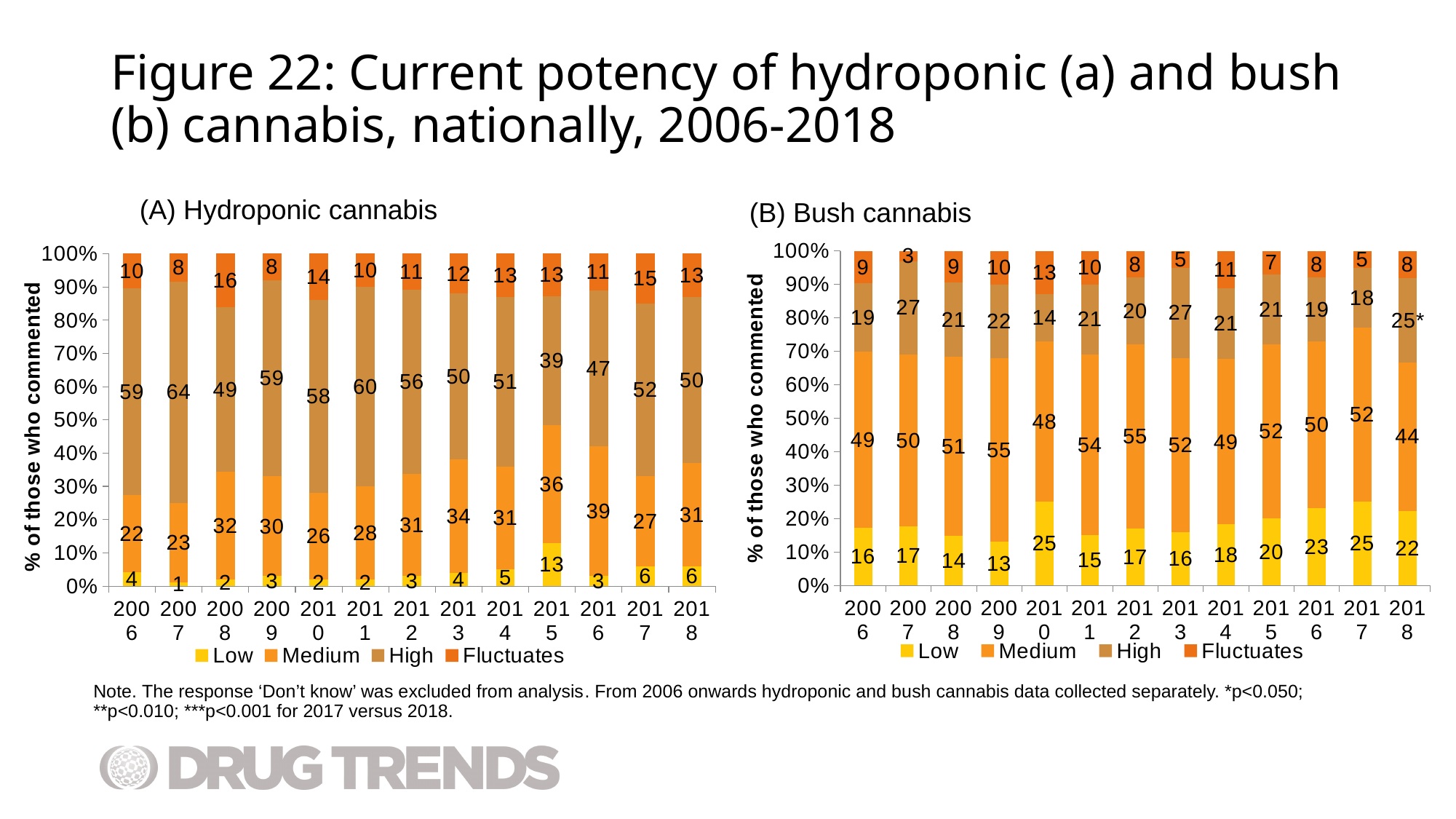
How many years are shown on the x axis of chart (A) Hydroponic cannabis? 13 In chart (B) Bush cannabis, what is the Medium value for 2018? 44 What is the y-axis label of chart (B) Bush cannabis? % of those who commented In chart (B) Bush cannabis, which year has the lowest Fluctuates value? 2007 In chart (A) Hydroponic cannabis, what is the difference between the High values for 2007 and 2015? 25 In chart (A) Hydroponic cannabis, what is the Low value for 2015? 13 In chart (A) Hydroponic cannabis, what percentage of those who commented rated potency as High in 2007? 64 In chart (A) Hydroponic cannabis, which year has the highest High value? 2007 What type of chart is chart (A) Hydroponic cannabis? Stacked bar chart In chart (B) Bush cannabis, what is the Fluctuates value for 2010? 13 In chart (B) Bush cannabis, which is larger, the Low value for 2010 or the Low value for 2009? 2010 How many series does the legend of chart (B) Bush cannabis list? 4